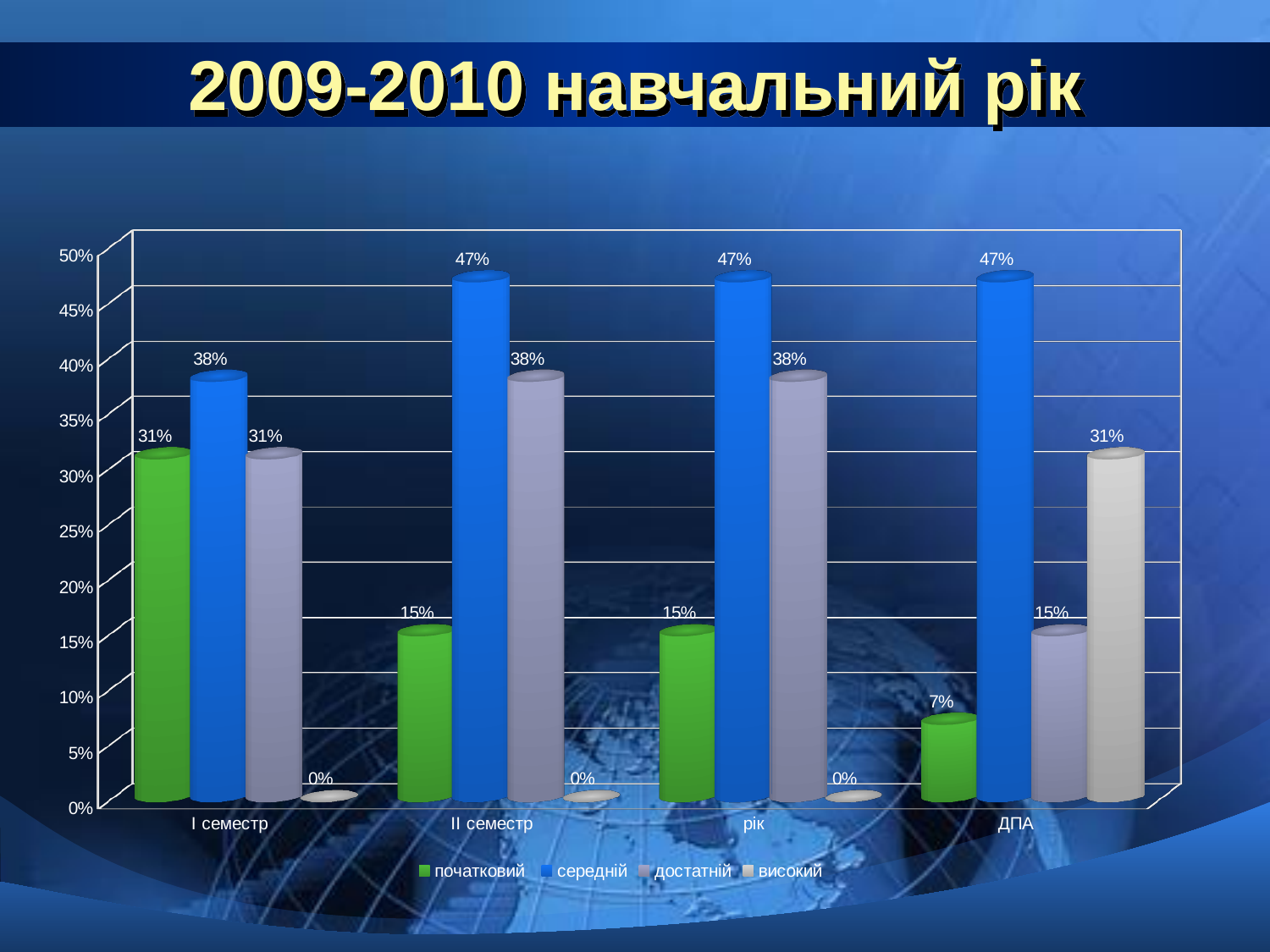
What kind of chart is shown on the slide? bar chart Which series has the highest value in ДПА? середній What is the value for достатній in II семестр? 38% Which series has the lowest value in I семестр? високий What is the value for середній in I семестр? 38% What is the value for високий in ДПА? 31% What is the value for початковий in ДПА? 7% Which is larger in ДПА: достатній or високий? високий How many categories are shown on the x axis? 4 How many series does the legend list? 4 What is the title of the slide? 2009-2010 навчальний рік What is the difference between середній and початковий in II семестр? 32%